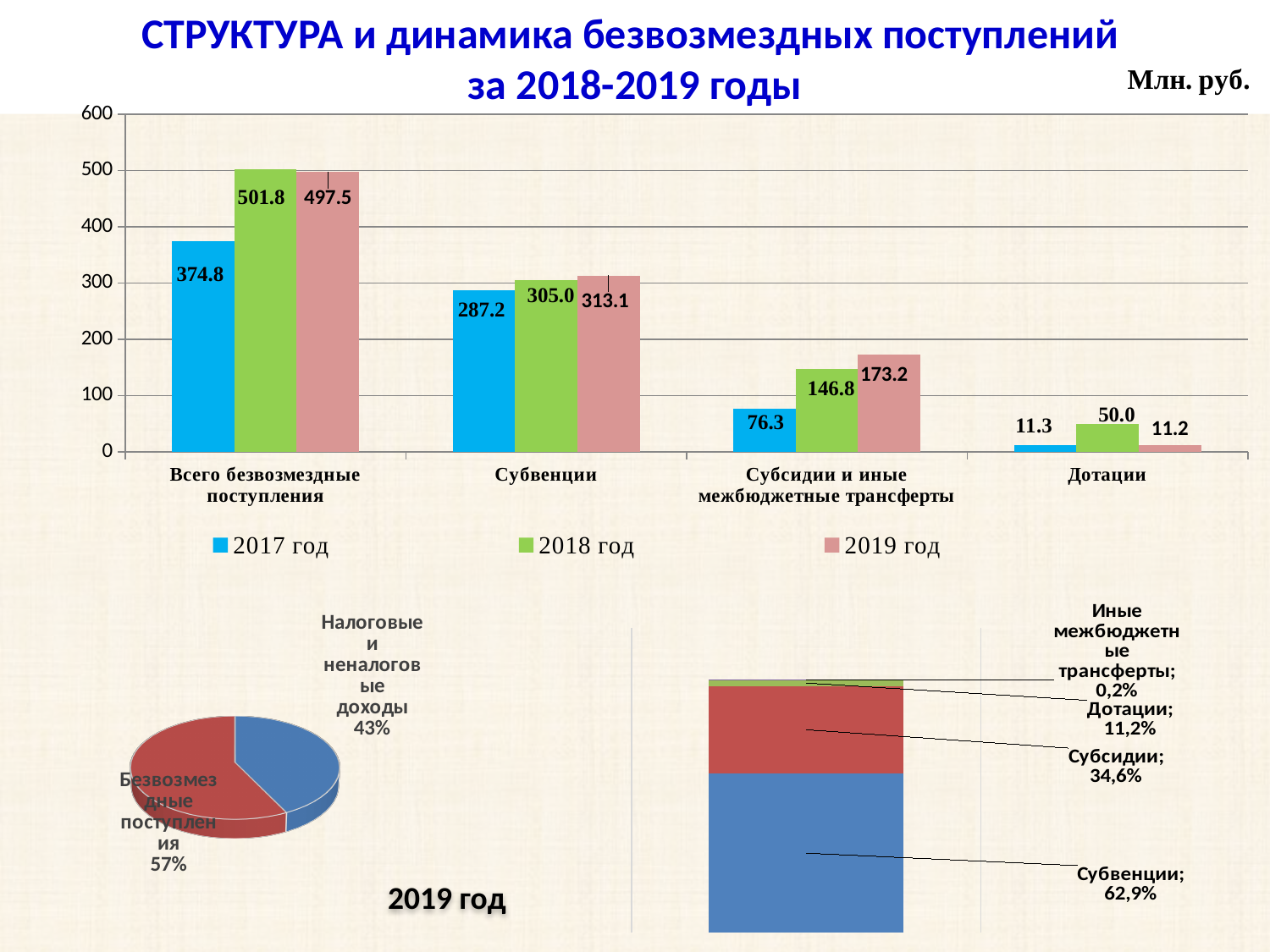
In the pie chart at the bottom left, what share is Безвозмездные поступления? 57% In the top bar chart, what is the difference between the 2018 год and 2017 год values for Всего безвозмездные поступления? 127.0 In the top bar chart, do the values for Субвенции rise or fall from 2017 год to 2019 год? rise How many categories are shown on the x axis of the top bar chart? 4 In the top bar chart, what is the value for Дотации in 2018 год? 50.0 In the top bar chart, which is larger for Субсидии и иные межбюджетные трансферты: the 2018 год value or the 2019 год value? 2019 год In the top bar chart, what is the value for Субсидии и иные межбюджетные трансферты in 2017 год? 76.3 In the top bar chart, what is the value for Субвенции in 2019 год? 313.1 In the top bar chart, which year has the highest value for Всего безвозмездные поступления? 2018 год In the stacked bar at the bottom right, what is the value for Субсидии? 34,6% How many series does the legend of the top bar chart list? 3 In the top bar chart, which category has the lowest value in 2019 год? Дотации